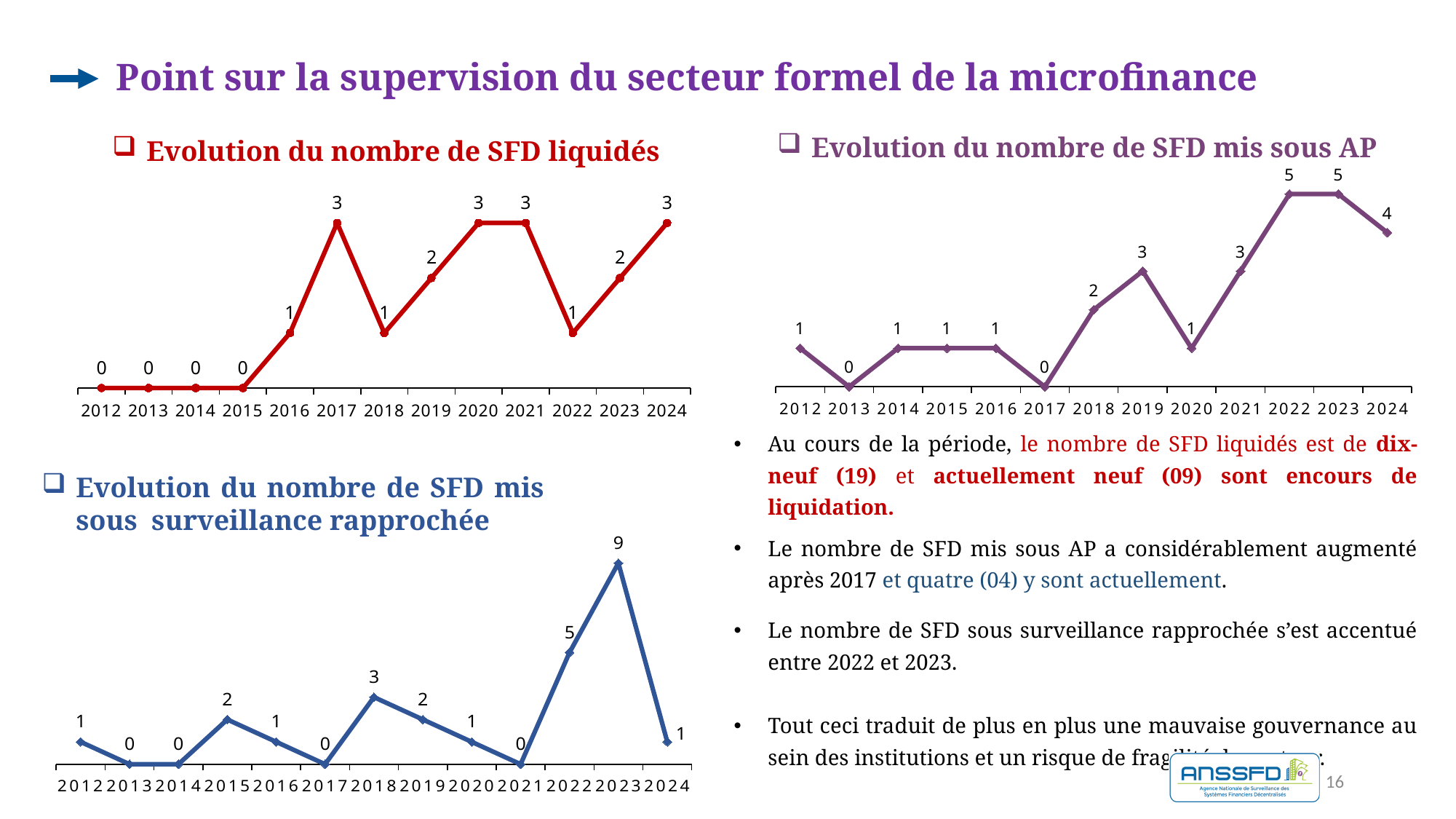
In the chart 'Evolution du nombre de SFD liquidés', what is the value for 2017? 3 In the chart 'Evolution du nombre de SFD mis sous surveillance rapprochée', which year has the highest value? 2023 In the chart 'Evolution du nombre de SFD mis sous AP', what is the difference between the values for 2022 and 2019? 2 What kind of chart is 'Evolution du nombre de SFD mis sous AP'? Line chart In the chart 'Evolution du nombre de SFD liquidés', how many years are plotted on the x axis? 13 In the chart 'Evolution du nombre de SFD mis sous AP', which years have the highest value? 2022 and 2023 In the chart 'Evolution du nombre de SFD mis sous AP', what is the value for 2024? 4 In the chart 'Evolution du nombre de SFD mis sous surveillance rapprochée', what is the difference between the values for 2023 and 2024? 8 In the chart 'Evolution du nombre de SFD mis sous surveillance rapprochée', what is the value for 2022? 5 In the chart 'Evolution du nombre de SFD liquidés', do the values rise or fall from 2021 to 2022? Fall In the chart 'Evolution du nombre de SFD liquidés', what is the value for 2023? 2 In the chart 'Evolution du nombre de SFD mis sous surveillance rapprochée', is the value for 2018 larger or the value for 2019? 2018